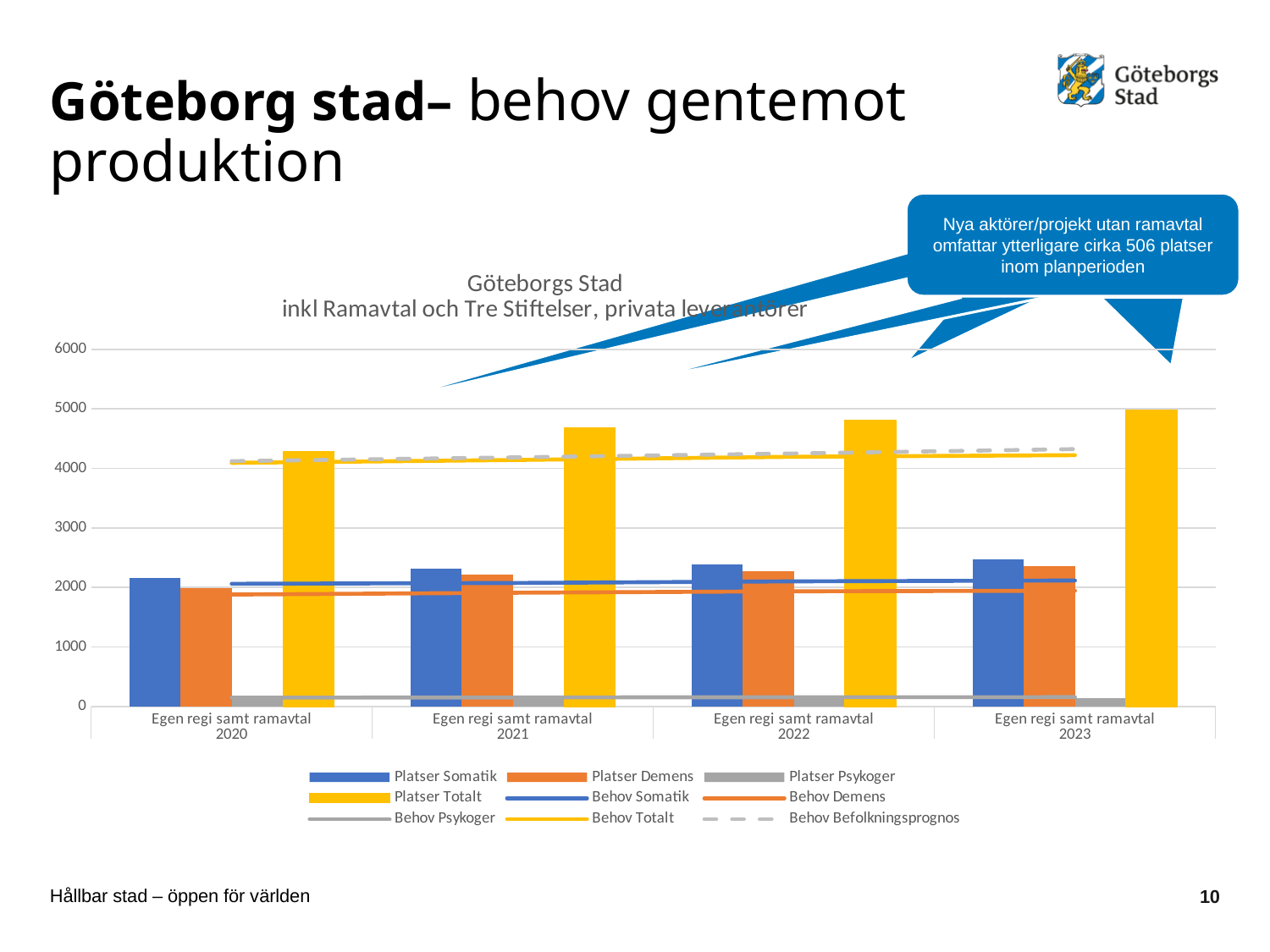
Which legend entry is drawn as a grey dashed line? Behov Befolkningsprognos How many categories are shown on the x axis of the chart? 4 In which category is the Platser Totalt bar highest? Egen regi samt ramavtal 2023 How many series does the chart's legend list? 9 Is the value of Platser Totalt for Egen regi samt ramavtal 2021 greater or less than 5000? less Is the value of Platser Demens for Egen regi samt ramavtal 2022 greater or less than 3000? less For Egen regi samt ramavtal 2020, which is larger: Platser Somatik or Platser Demens? Platser Somatik What is the title of the chart? Göteborgs Stad inkl Ramavtal och Tre Stiftelser, privata leverantörer What kind of chart is shown on the slide? bar chart with line series Do the Platser Totalt bars rise or fall from 2020 to 2023? rise Is the value of Platser Psykoger for Egen regi samt ramavtal 2020 greater or less than 1000? less